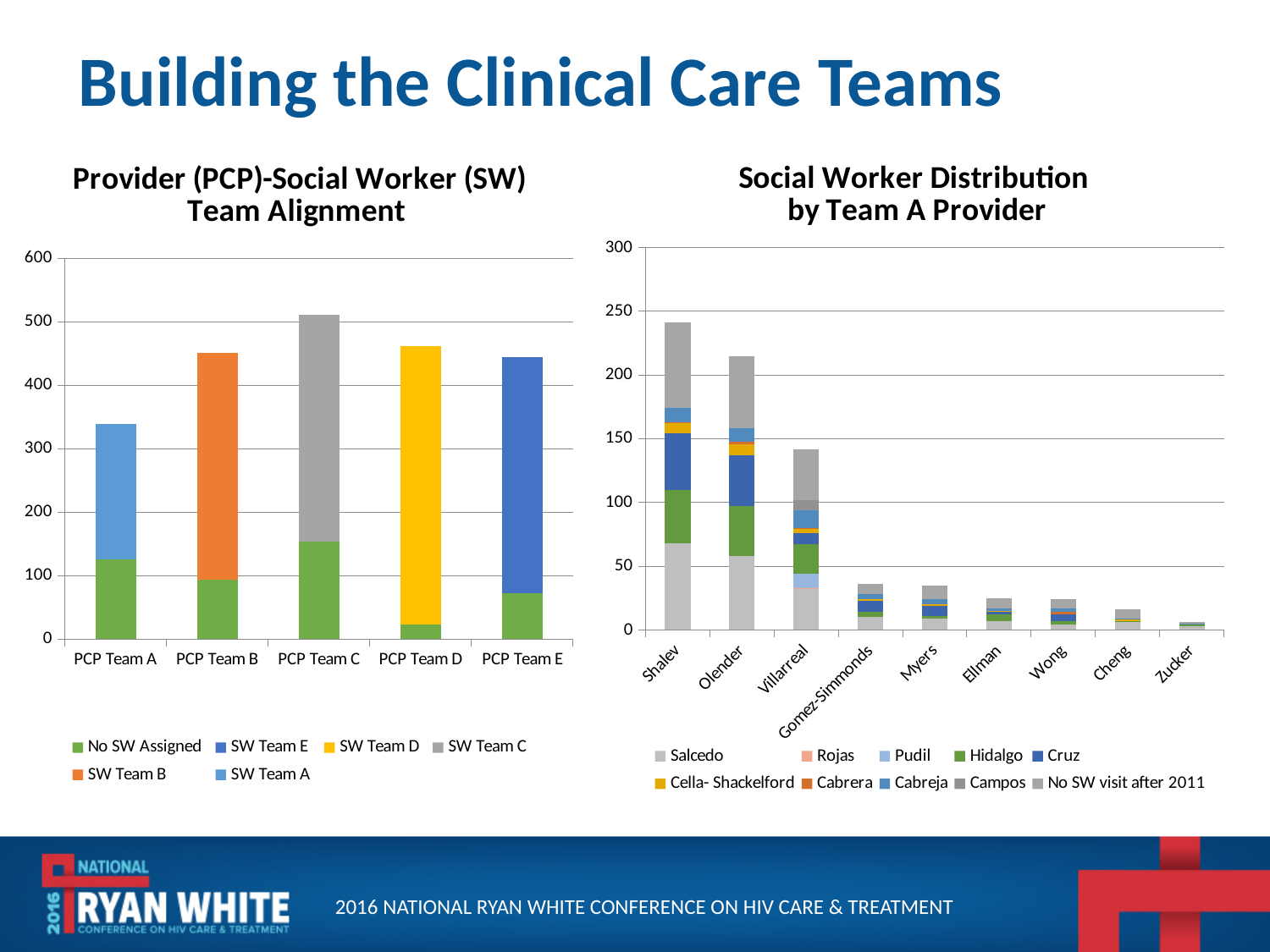
What kind of chart is the 'Provider (PCP)-Social Worker (SW) Team Alignment' chart? Stacked bar chart How many series does the legend of the 'Provider (PCP)-Social Worker (SW) Team Alignment' chart list? 6 In the 'Social Worker Distribution by Team A Provider' chart, is the total for Zucker greater or less than 50? less In the 'Social Worker Distribution by Team A Provider' chart, which provider has the tallest bar? Shalev How many series does the legend of the 'Social Worker Distribution by Team A Provider' chart list? 10 In the 'Provider (PCP)-Social Worker (SW) Team Alignment' chart, which PCP team has the tallest bar? PCP Team C How many PCP teams are shown on the x axis of the 'Provider (PCP)-Social Worker (SW) Team Alignment' chart? 5 In the 'Provider (PCP)-Social Worker (SW) Team Alignment' chart, which PCP team has the shortest bar? PCP Team A In the 'Social Worker Distribution by Team A Provider' chart, do the bar totals rise or fall from left to right along the x axis? fall In the 'Provider (PCP)-Social Worker (SW) Team Alignment' chart, is the total for PCP Team C greater or less than 500? greater How many providers are shown on the x axis of the 'Social Worker Distribution by Team A Provider' chart? 9 In the 'Provider (PCP)-Social Worker (SW) Team Alignment' chart, is the total for PCP Team A greater or less than 300? greater